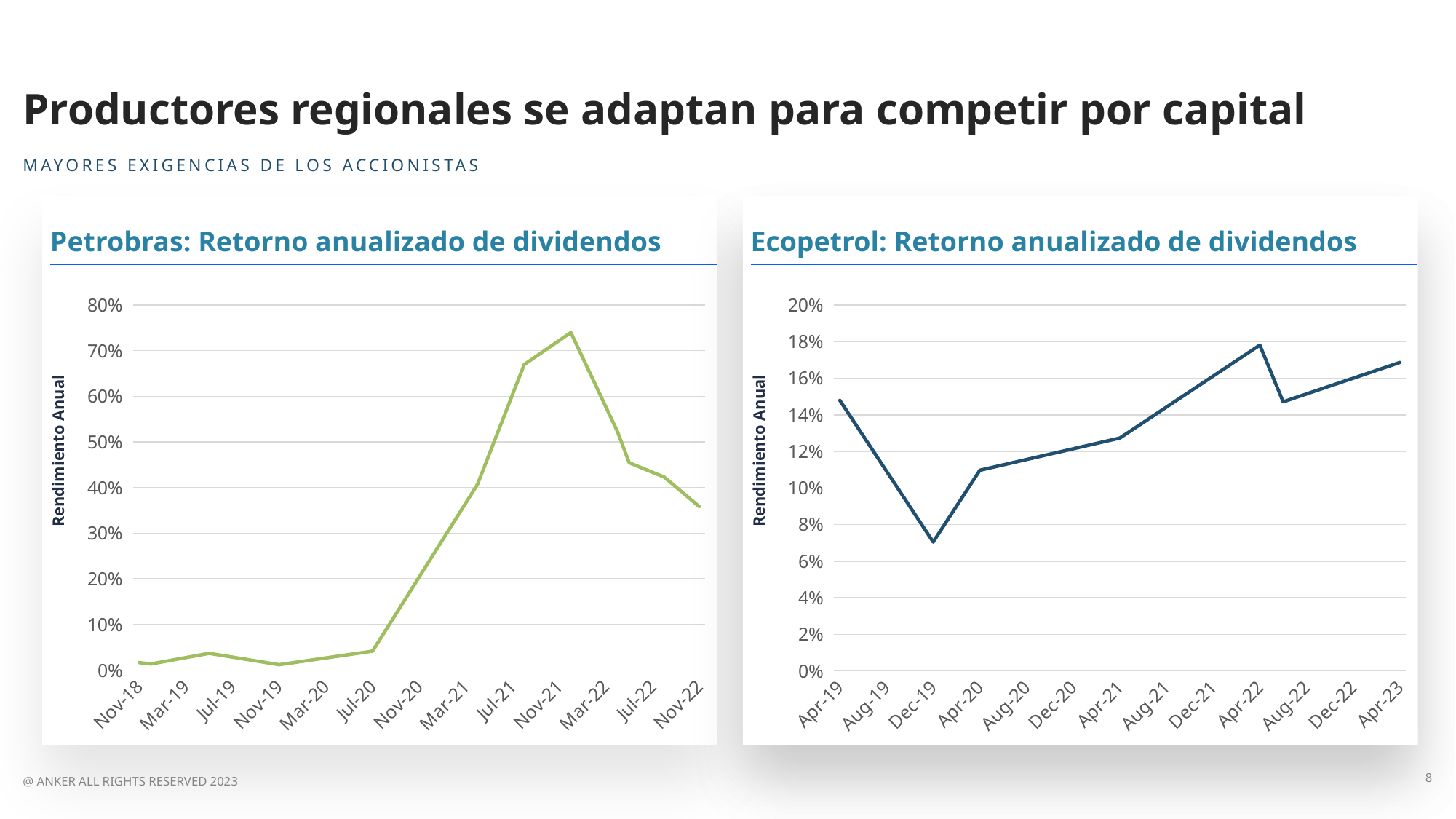
In the Petrobras: Retorno anualizado de dividendos chart, is the value for Nov-22 greater or less than 40%? less In the Petrobras: Retorno anualizado de dividendos chart, is the value for Jul-20 greater or less than 10%? less In the Ecopetrol: Retorno anualizado de dividendos chart, which x-axis label has the lowest value? Dec-19 What kind of chart is the Petrobras: Retorno anualizado de dividendos chart? line chart In the Ecopetrol: Retorno anualizado de dividendos chart, is the value for Apr-22 greater or less than 16%? greater In the Petrobras: Retorno anualizado de dividendos chart, how many labels are shown on the x axis? 13 What is the y-axis label on the Ecopetrol: Retorno anualizado de dividendos chart? Rendimiento Anual In the Ecopetrol: Retorno anualizado de dividendos chart, which is larger, the value for Apr-19 or the value for Dec-19? Apr-19